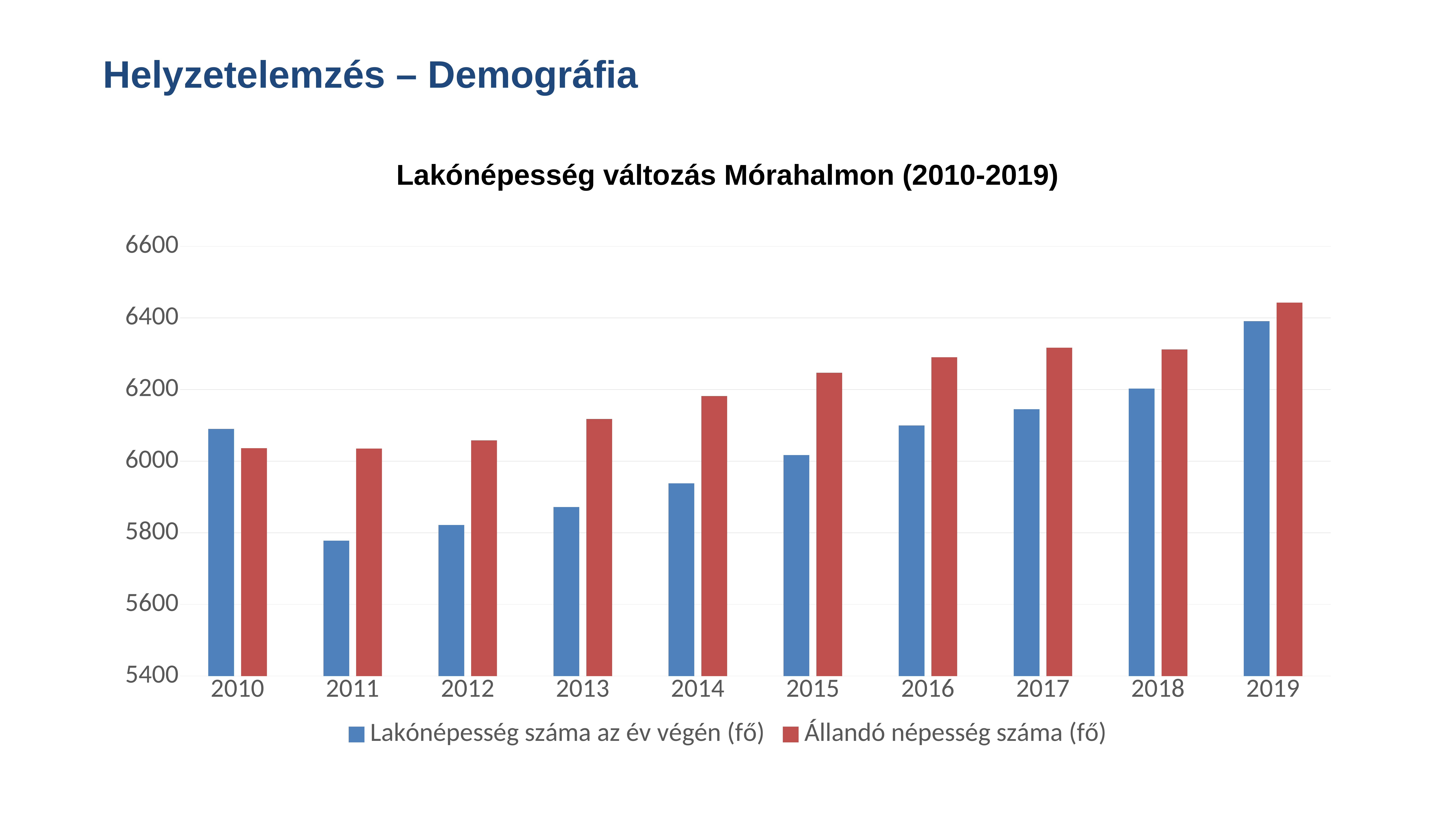
Which year has the highest value for Állandó népesség száma (fő)? 2019 Is the value for Lakónépesség száma az év végén (fő) in 2011 greater or less than 5800? less How many years are shown on the x axis? 10 What kind of chart is shown on the slide? Bar chart Is the value for Lakónépesség száma az év végén (fő) in 2014 greater or less than 6000? less Is the value for Állandó népesség száma (fő) in 2019 greater or less than 6400? greater Which year has the highest value for Lakónépesség száma az év végén (fő)? 2019 Which year has the lowest value for Lakónépesség száma az év végén (fő)? 2011 What is the title of the chart? Lakónépesség változás Mórahalmon (2010-2019) How many series does the legend list? 2 Does the value for Állandó népesség száma (fő) generally rise or fall from 2011 to 2019? Rise In 2013, which is larger: Lakónépesség száma az év végén (fő) or Állandó népesség száma (fő)? Állandó népesség száma (fő)